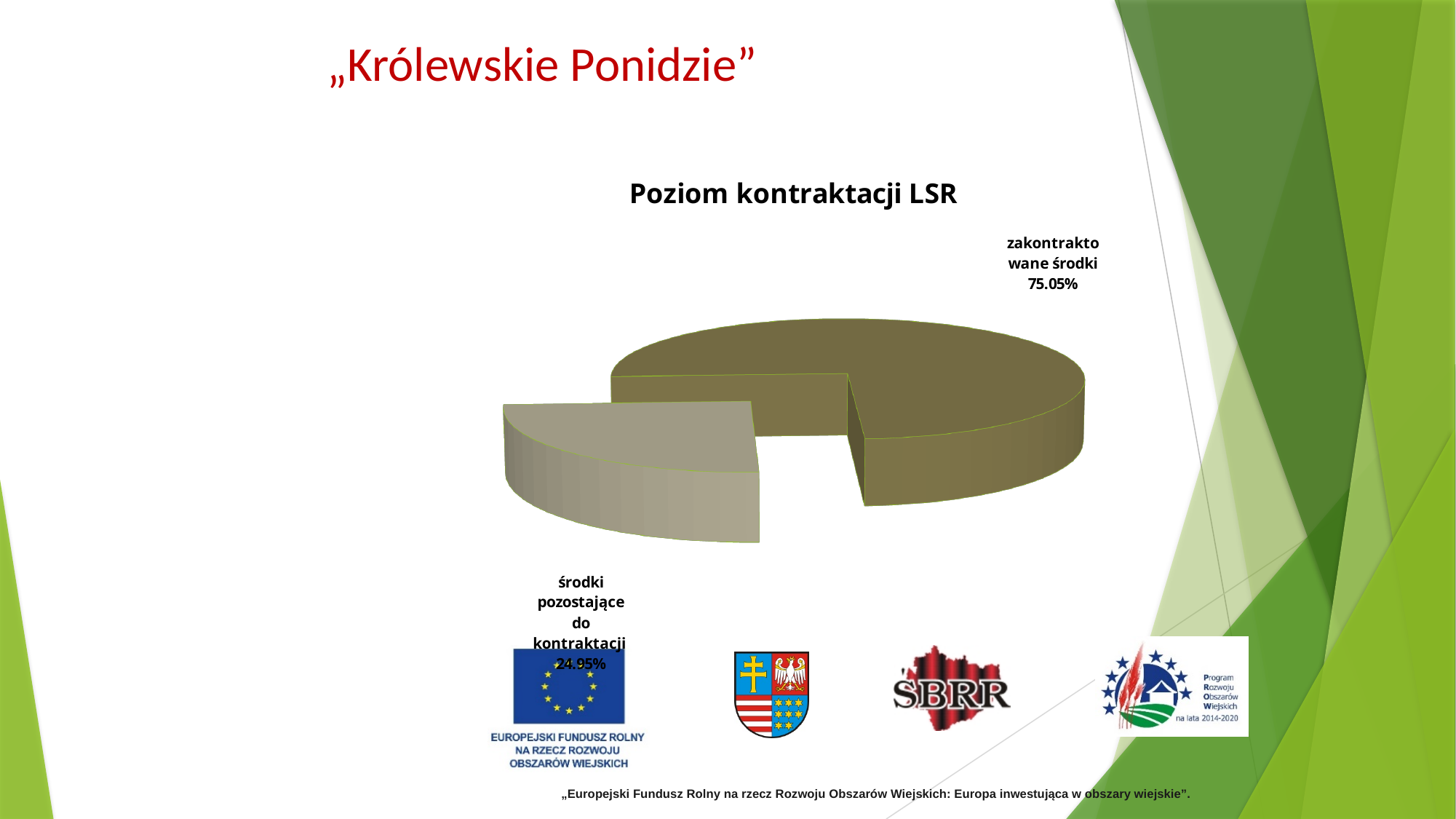
Which slice of the pie chart is pulled out (exploded) from the rest of the pie? środki pozostające do kontraktacji How many slices does the pie chart have? 2 Which slice of the pie chart is the largest? zakontraktowane środki What is the difference in percentage points between the "zakontraktowane środki" slice and the "środki pozostające do kontraktacji" slice? 50.10 Is the share for "zakontraktowane środki" greater or less than 50%? greater What share of the pie is labelled "zakontraktowane środki"? 75.05% What is the title of the chart? Poziom kontraktacji LSR Is the share for "środki pozostające do kontraktacji" greater or less than 30%? less Which is larger: the share for "zakontraktowane środki" or the share for "środki pozostające do kontraktacji"? zakontraktowane środki What type of chart is shown on the slide? pie chart What share of the pie is labelled "środki pozostające do kontraktacji"? 24.95% Which slice of the pie chart is the smallest? środki pozostające do kontraktacji